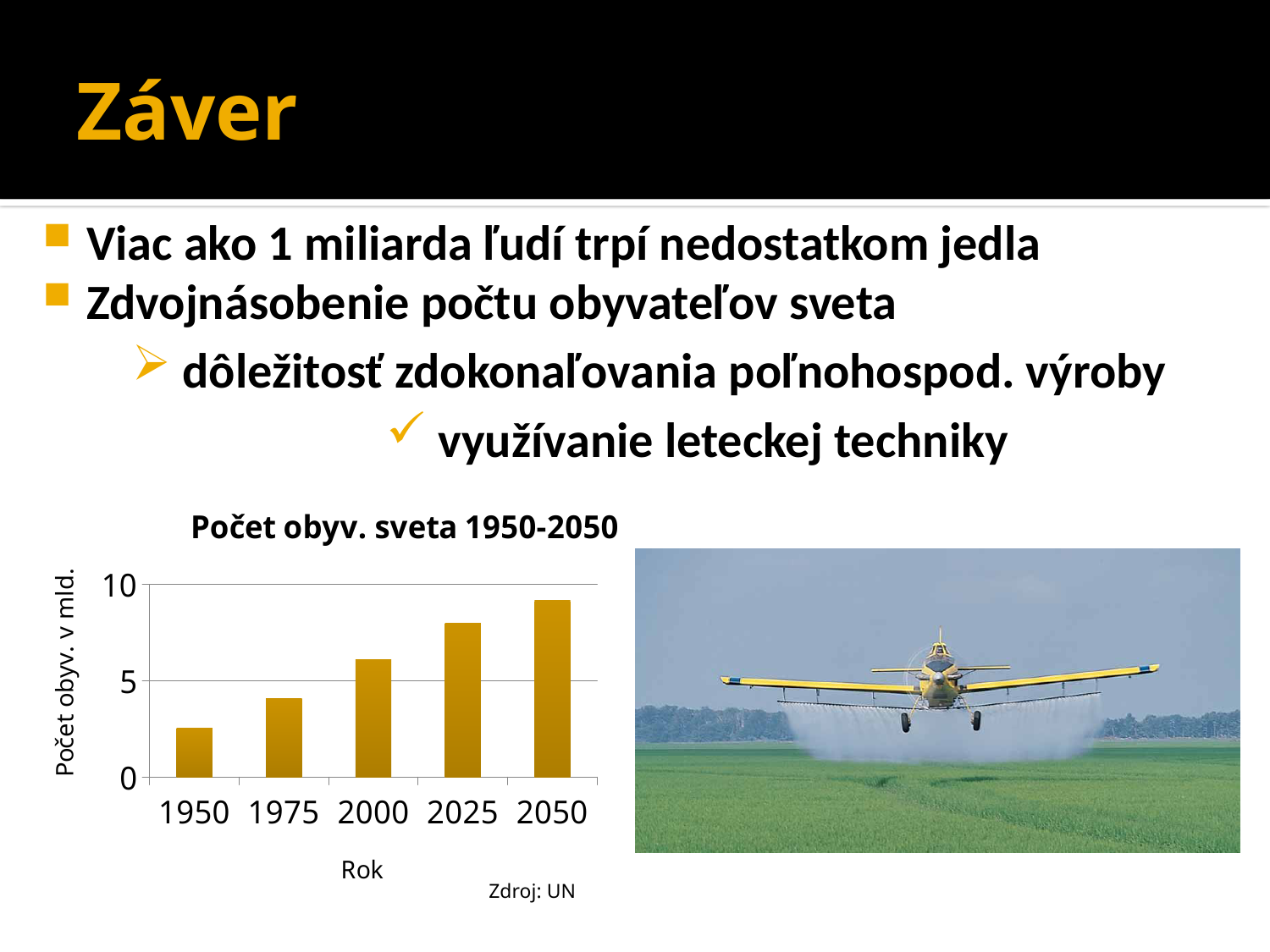
Is the value for 1975 greater or less than 5? less What is the title of the chart? Počet obyv. sveta 1950-2050 Which year has the highest value in the chart? 2050 Do the values rise or fall from 1950 to 2050? rise Is the value for 1950 greater or less than 5? less Is the value for 2050 greater or less than 5? greater What kind of chart is shown on the slide? bar chart Which year has the lowest value in the chart? 1950 What is the label of the vertical axis of the chart? Počet obyv. v mld. Which is larger, the value for 2025 or the value for 1975? 2025 How many years (bars) are shown in the chart? 5